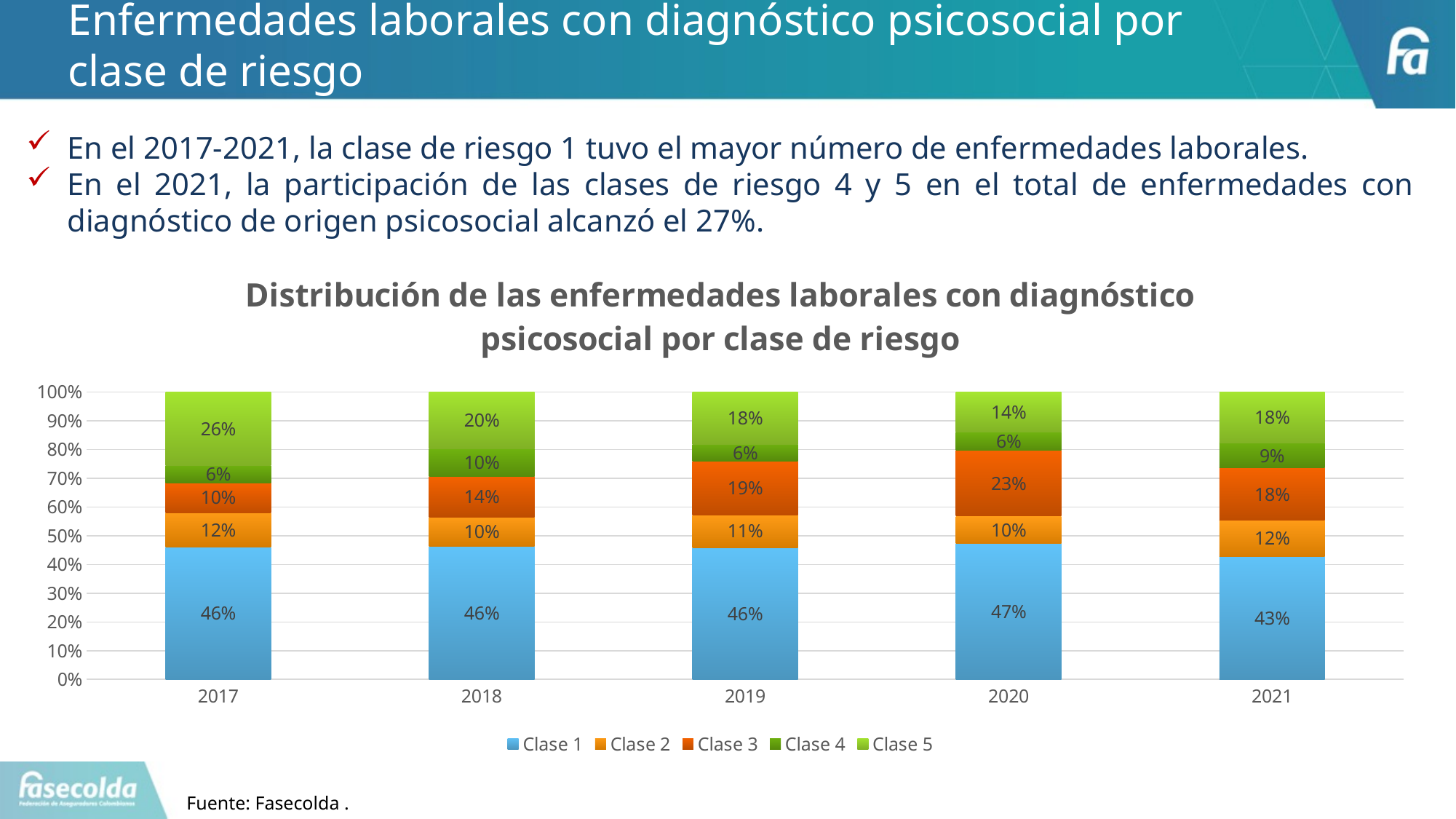
What is the value for Clase 4 in 2018? 10% In which year is the Clase 3 value highest? 2020 What is the combined share of Clase 4 and Clase 5 in 2021? 27% What is the value for Clase 5 in 2017? 26% Which is larger in 2019: the Clase 2 value or the Clase 3 value? Clase 3 How many series does the legend list? 5 What is the value for Clase 1 in 2021? 43% How many years are shown on the x axis? 5 In which year is the Clase 5 value lowest? 2020 What kind of chart is shown? Stacked bar chart What is the value for Clase 3 in 2020? 23% What is the difference between the Clase 5 value in 2017 and in 2021? 8%